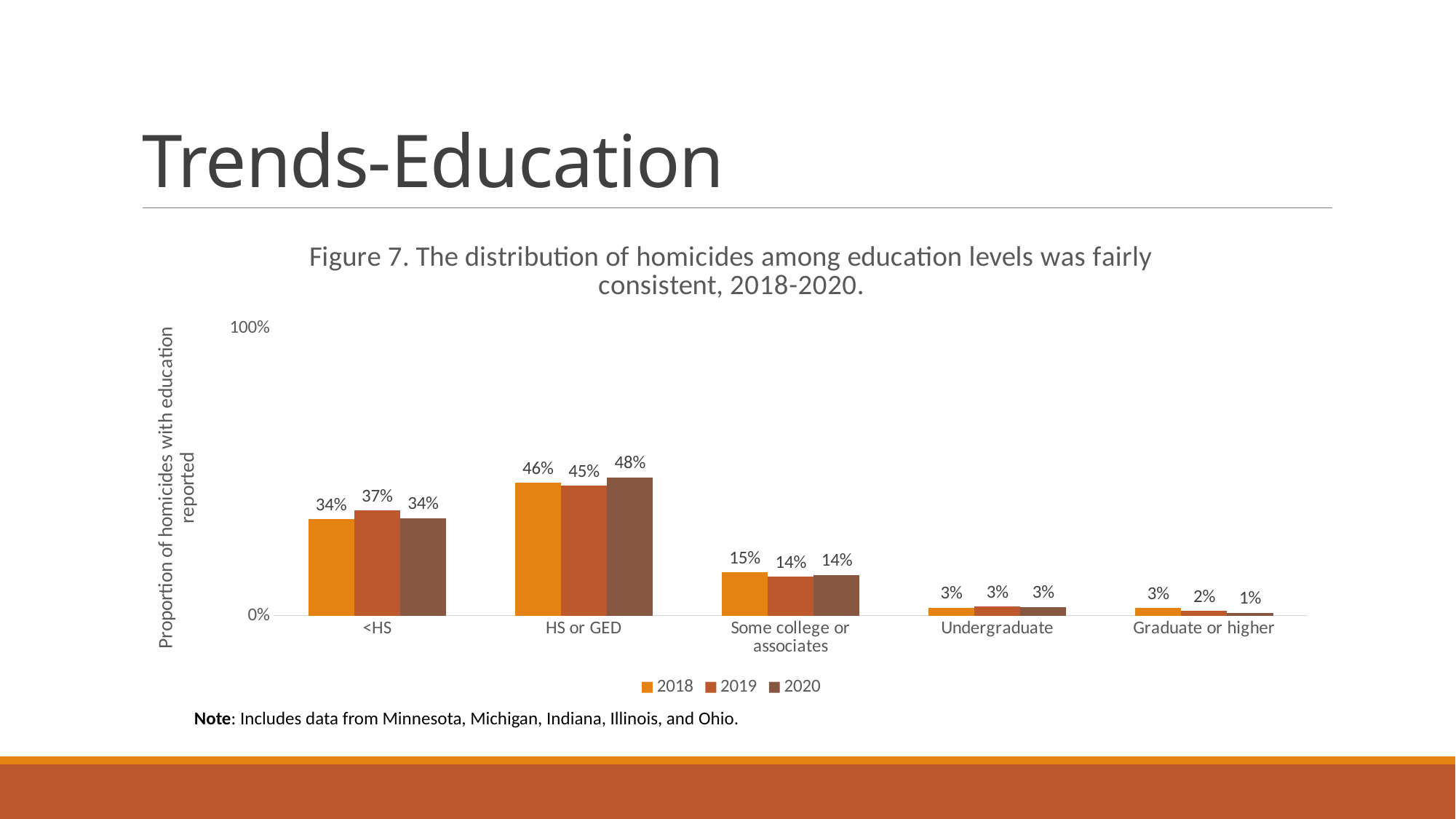
What is the y-axis label of the chart? Proportion of homicides with education reported How many education level categories are shown on the x axis? 5 Which is larger for <HS: the 2019 value or the 2020 value? 2019 What is the value for HS or GED in 2020? 48% How many series does the legend list? 3 What is the value for <HS in 2019? 37% What is the difference between the 2020 and 2019 values for HS or GED? 3% What is the value for Graduate or higher in 2020? 1% What is the value for Some college or associates in 2018? 15% Which education level has the lowest value in 2020? Graduate or higher What kind of chart is shown on the slide? Bar chart Which education level has the highest value in 2018? HS or GED